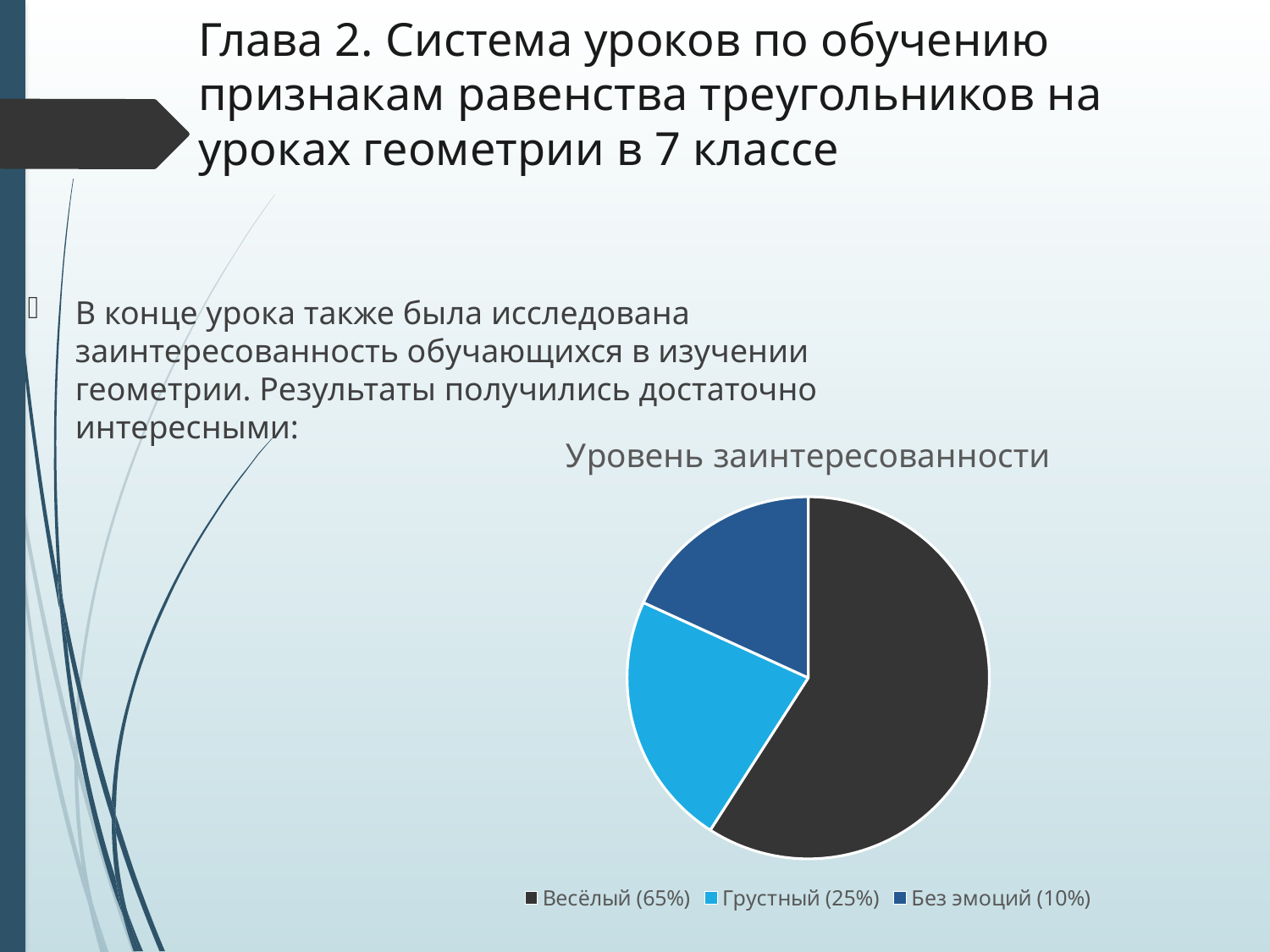
What is the title of the chart? Уровень заинтересованности What share of the pie does the Весёлый slice represent? 65% What share of the pie does the Без эмоций slice represent? 10% Is the share for Весёлый greater or less than 50%? greater How many slices does the pie chart have? 3 What is the difference in percentage points between the Весёлый and Грустный slices? 40 Which category has the largest slice of the pie? Весёлый What share of the pie does the Грустный slice represent? 25% Which is larger, the Грустный slice or the Без эмоций slice? Грустный Which colour is used for the Грустный slice? light blue What kind of chart is shown on the slide? pie chart Which category has the smallest slice of the pie? Без эмоций